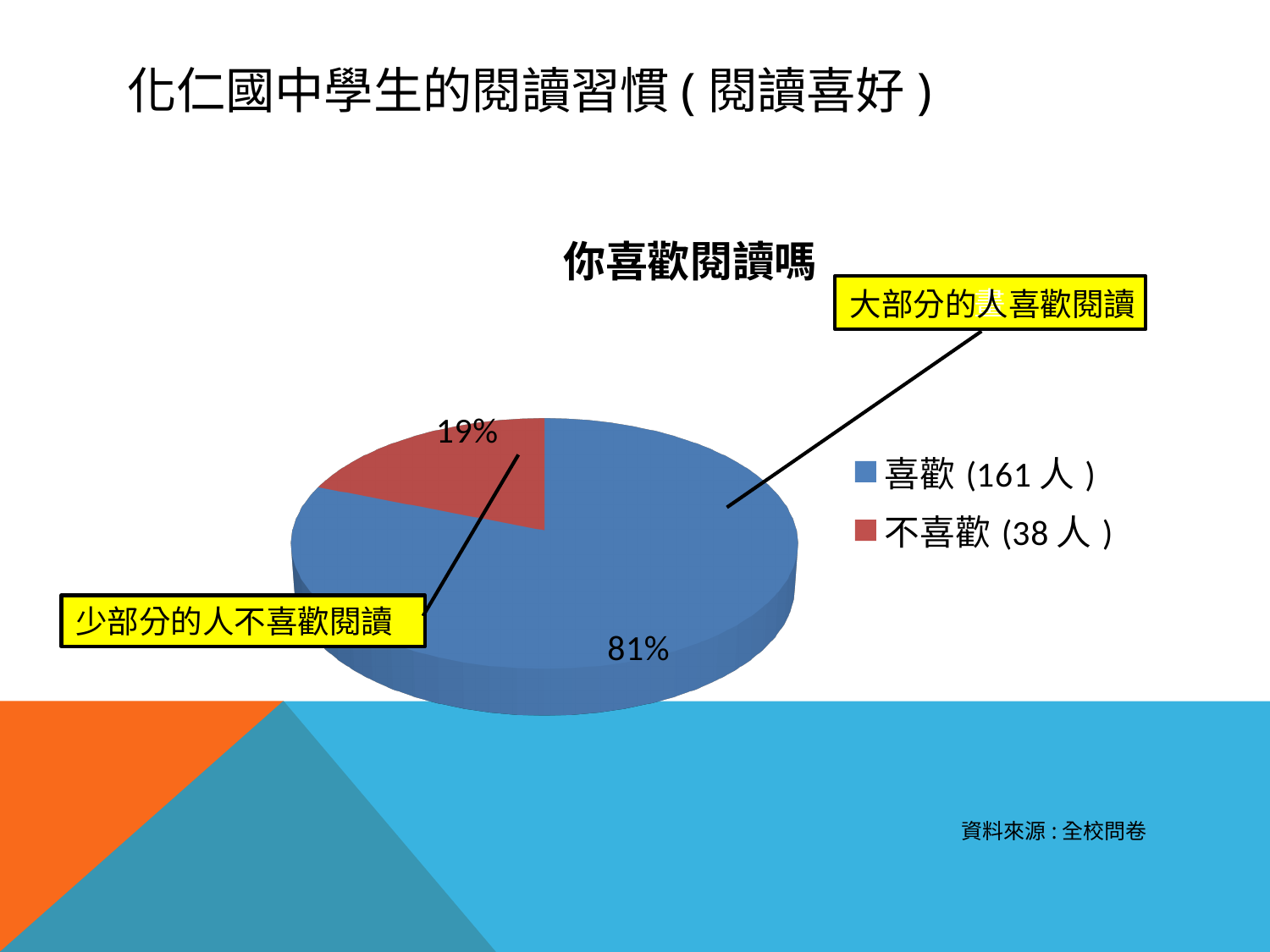
Which slice of the pie is the smallest? 不喜歡 Which slice of the pie is the largest? 喜歡 How many entries does the legend list? 2 What is the difference in percentage points between the 喜歡 and 不喜歡 slices? 62 What percentage of the pie is the 不喜歡 slice? 19% What is the title of the chart? 你喜歡閱讀嗎 How many people answered 不喜歡 according to the legend? 38 人 What percentage of the pie is the 喜歡 slice? 81% What colour is the 不喜歡 slice? Red How many slices does the pie chart have? 2 What type of chart is shown on the slide? Pie chart How many people answered 喜歡 according to the legend? 161 人